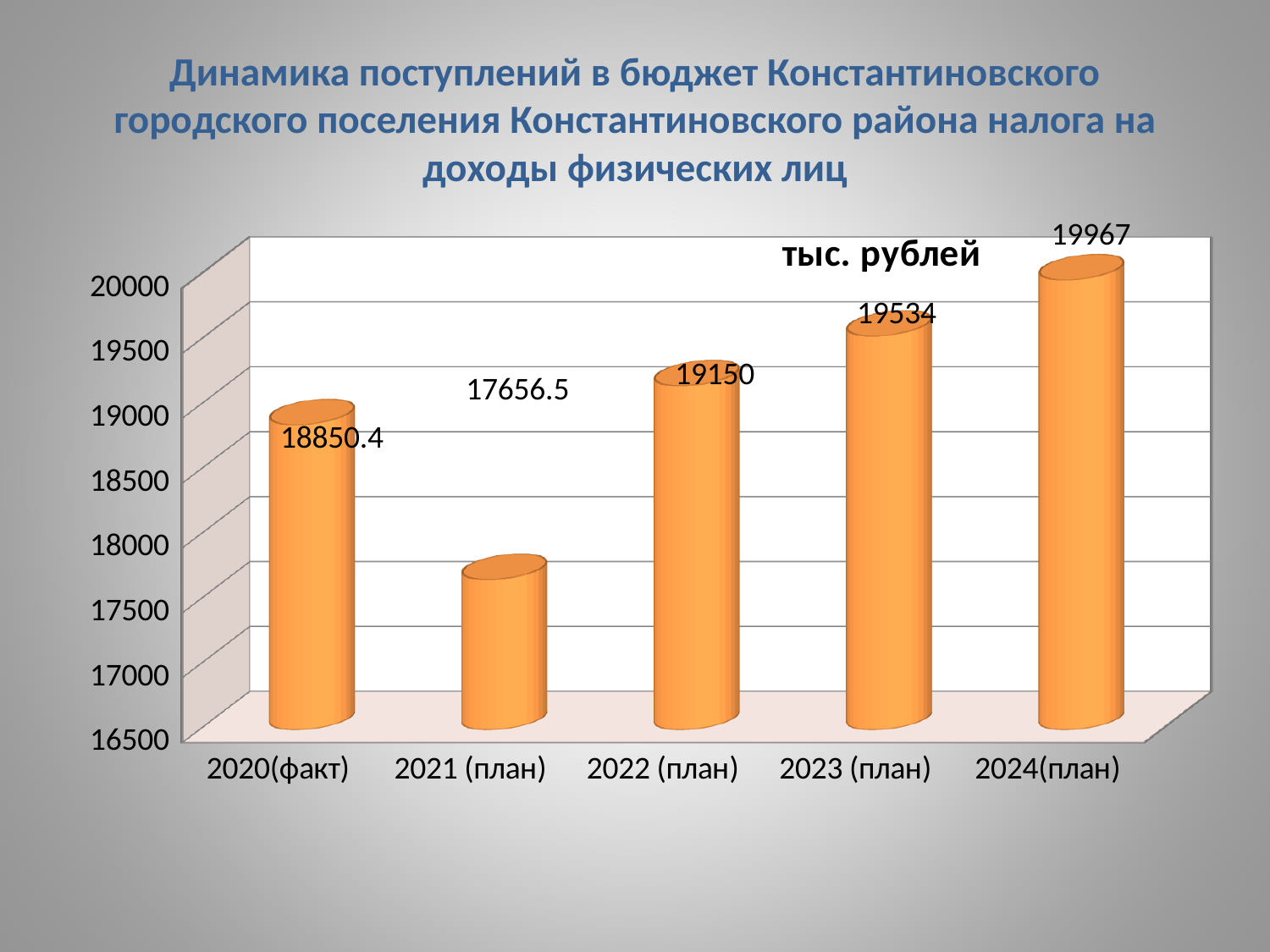
Which category has the lowest value? 2021 (план) What is the difference between the values for 2024(план) and 2023 (план)? 433 What is the difference between the values for 2022 (план) and 2021 (план)? 1493.5 Is the value for 2021 (план) greater or less than 18000? less What is the value for 2023 (план)? 19534 Do the values rise or fall from 2021 (план) to 2024(план)? rise How many categories are shown on the x axis? 5 What kind of chart is shown on the slide? bar chart Which category has the highest value? 2024(план) What is the value for 2021 (план)? 17656.5 What is the value for 2020(факт)? 18850.4 Which is larger, the value for 2020(факт) or the value for 2022 (план)? 2022 (план)